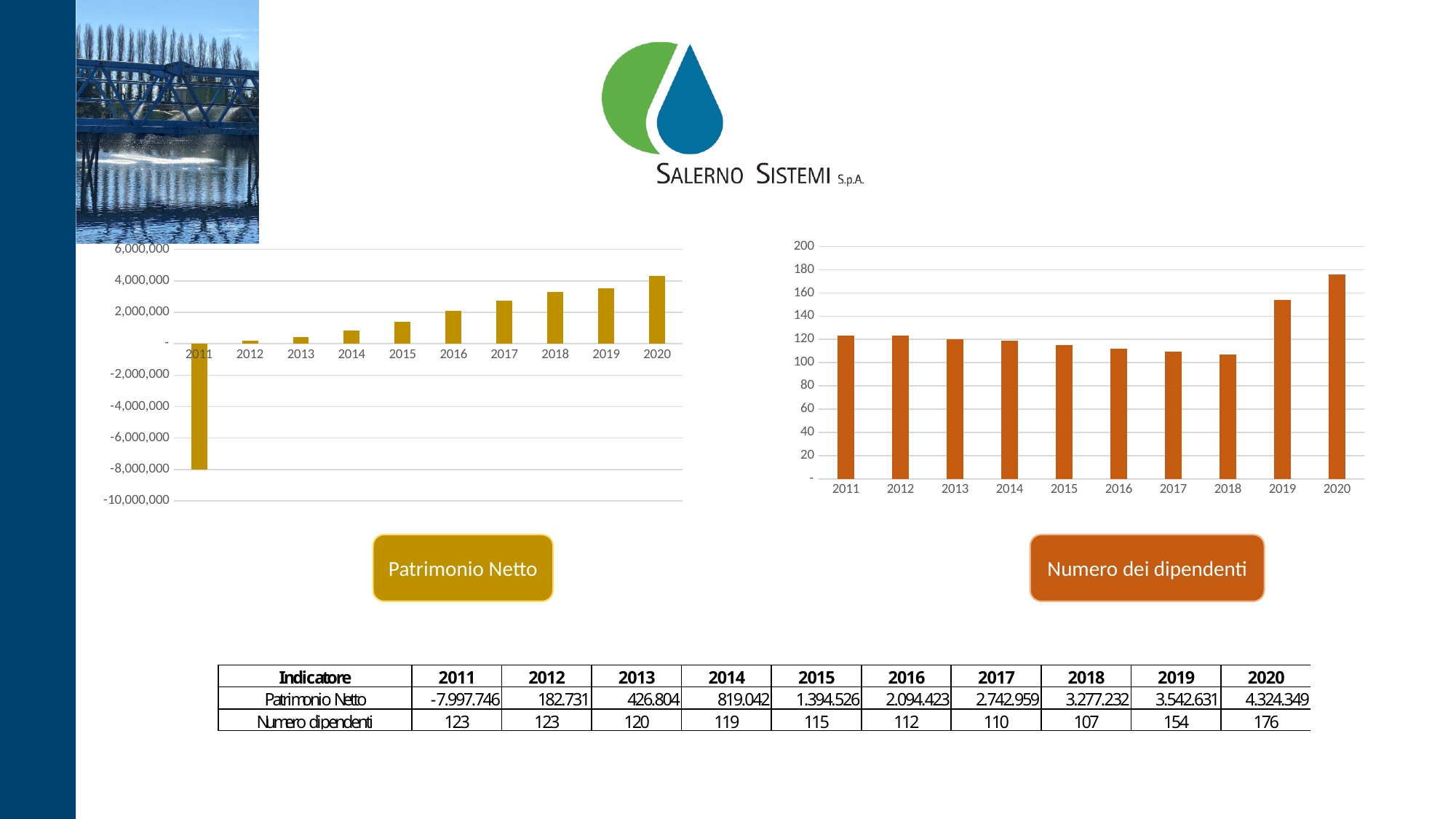
In the Patrimonio Netto chart, do the values rise or fall from 2012 to 2020? rise In the Numero dei dipendenti chart, what is the difference between the values for 2020 and 2019? 22 In the Patrimonio Netto chart, which year has the highest value? 2020 What type of chart is the Patrimonio Netto chart on the left? bar chart How many years are shown on the x axis of the Numero dei dipendenti chart? 10 In the Patrimonio Netto chart, what is the value for 2020? 4.324.349 In the Numero dei dipendenti chart, is the value for 2019 greater or less than 140? greater In the Numero dei dipendenti chart, which year has the lowest value? 2018 In the Numero dei dipendenti chart, what is the value for 2020? 176 In the Patrimonio Netto chart, is the value for 2017 greater or less than 2,000,000? greater In the Patrimonio Netto chart, what is the value for 2011? -7.997.746 In the Numero dei dipendenti chart, what is the value for 2018? 107